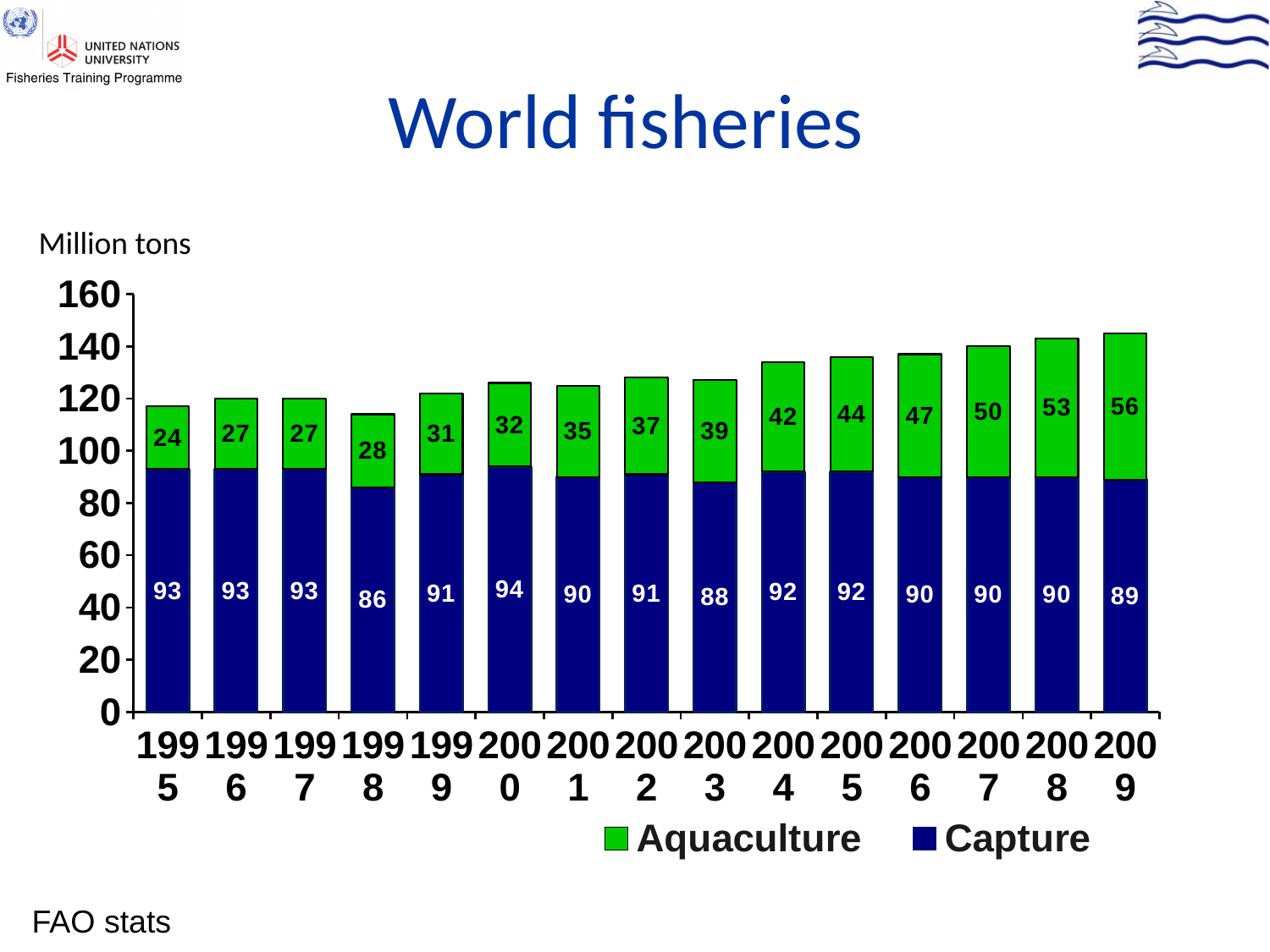
Which year has the highest Aquaculture value? 2009 What is the difference between the Aquaculture values for 2009 and 1995? 32 What is the Capture value for 1998? 86 Which year has the lowest Capture value? 1998 Do the Aquaculture values rise or fall from 1995 to 2009? Rise Which is larger, the Capture value for 2000 or the Capture value for 2003? Capture value for 2000 What kind of chart is shown on the slide? Stacked bar chart What is the total of the stacked bar for 1995? 117 How many years are shown on the x axis? 15 How many series does the legend list? 2 What is the Aquaculture value for 2009? 56 What is the total of the stacked bar for 2009? 145